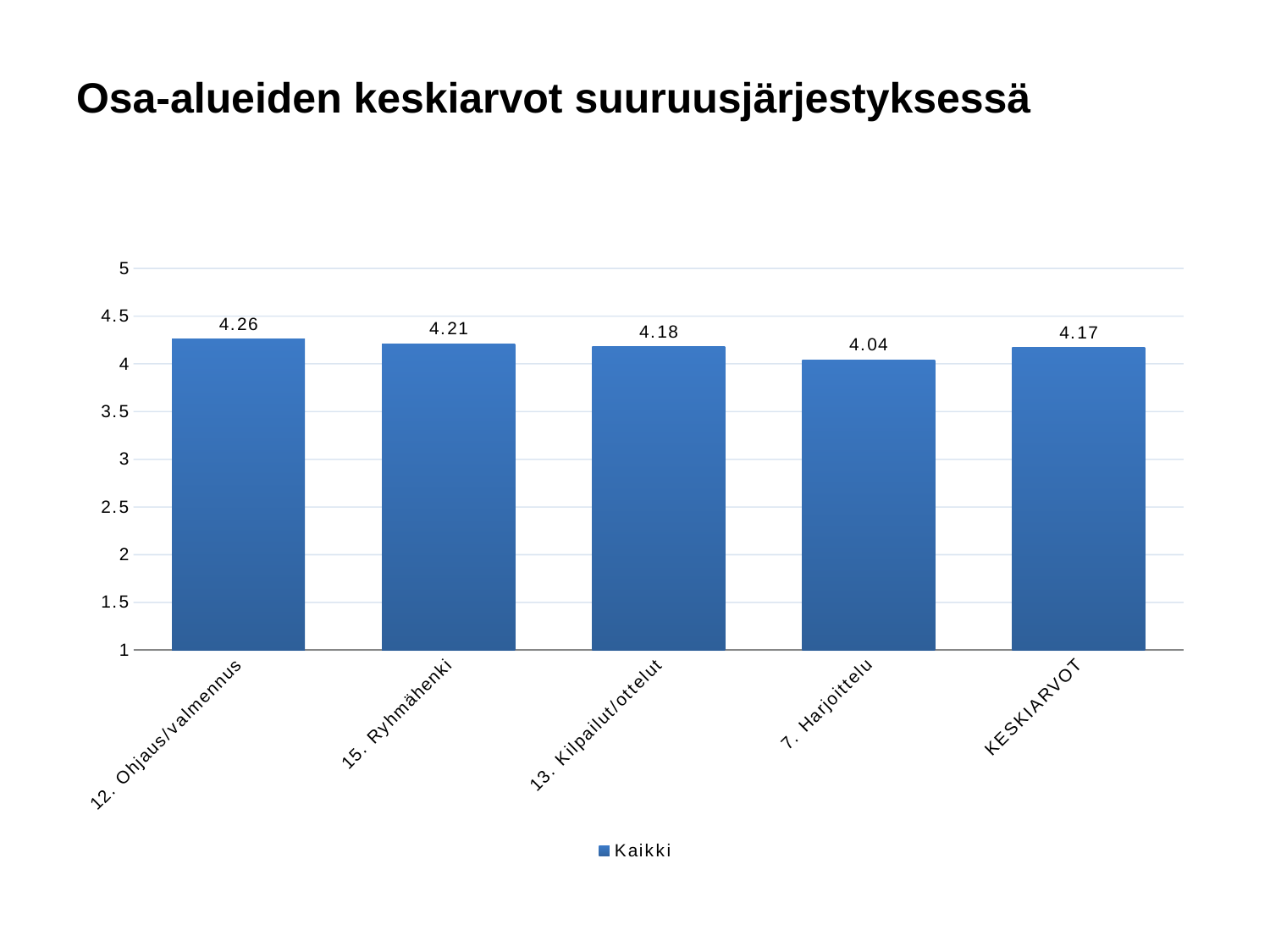
What is the value for 13. Kilpailut/ottelut? 4.18 What series name does the legend show? Kaikki Is the value for 7. Harjoittelu greater or less than 4.5? less Which is larger, the value for 15. Ryhmähenki or the value for 7. Harjoittelu? 15. Ryhmähenki What is the value for 12. Ohjaus/valmennus? 4.26 What is the value for 7. Harjoittelu? 4.04 How many categories are shown on the x axis? 5 Which category has the lowest value? 7. Harjoittelu What is the value for KESKIARVOT? 4.17 What is the difference between the values for 12. Ohjaus/valmennus and 7. Harjoittelu? 0.22 Which category has the highest value? 12. Ohjaus/valmennus What kind of chart is shown on the slide? bar chart